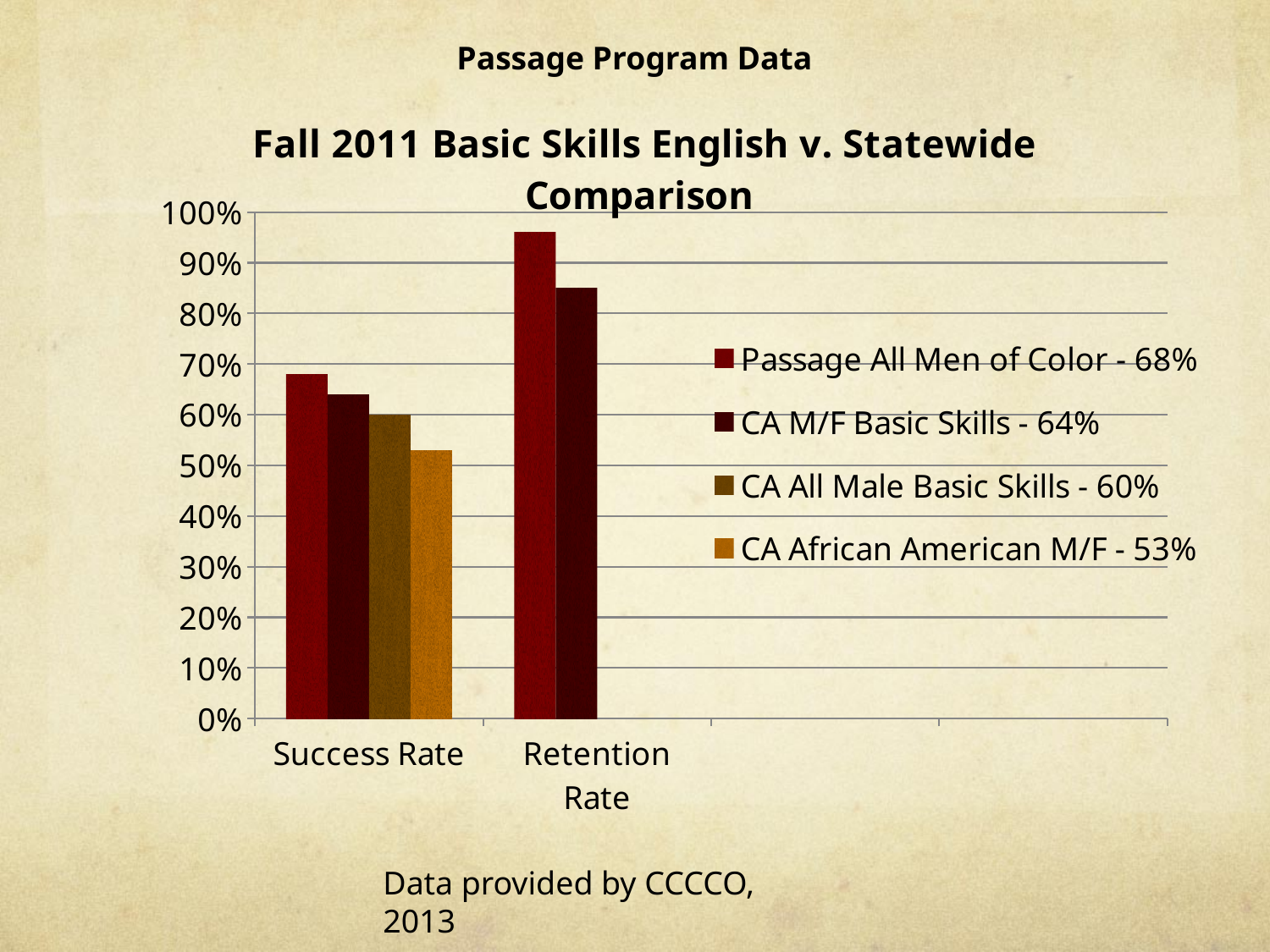
How many series does the legend list? 4 What is the Success Rate for CA All Male Basic Skills? 60% Which series has the highest Success Rate? Passage All Men of Color Is the Retention Rate for CA M/F Basic Skills greater or less than 90%? less What is the Success Rate for CA African American M/F? 53% What is the difference between the Success Rate for Passage All Men of Color and CA M/F Basic Skills? 4% Is the Retention Rate for Passage All Men of Color greater or less than 90%? greater What is the Success Rate for Passage All Men of Color? 68% What is the title of the chart? Fall 2011 Basic Skills English v. Statewide Comparison What kind of chart is shown on the slide? bar chart Which series has the lowest Success Rate? CA African American M/F How many categories are shown on the x axis? 2